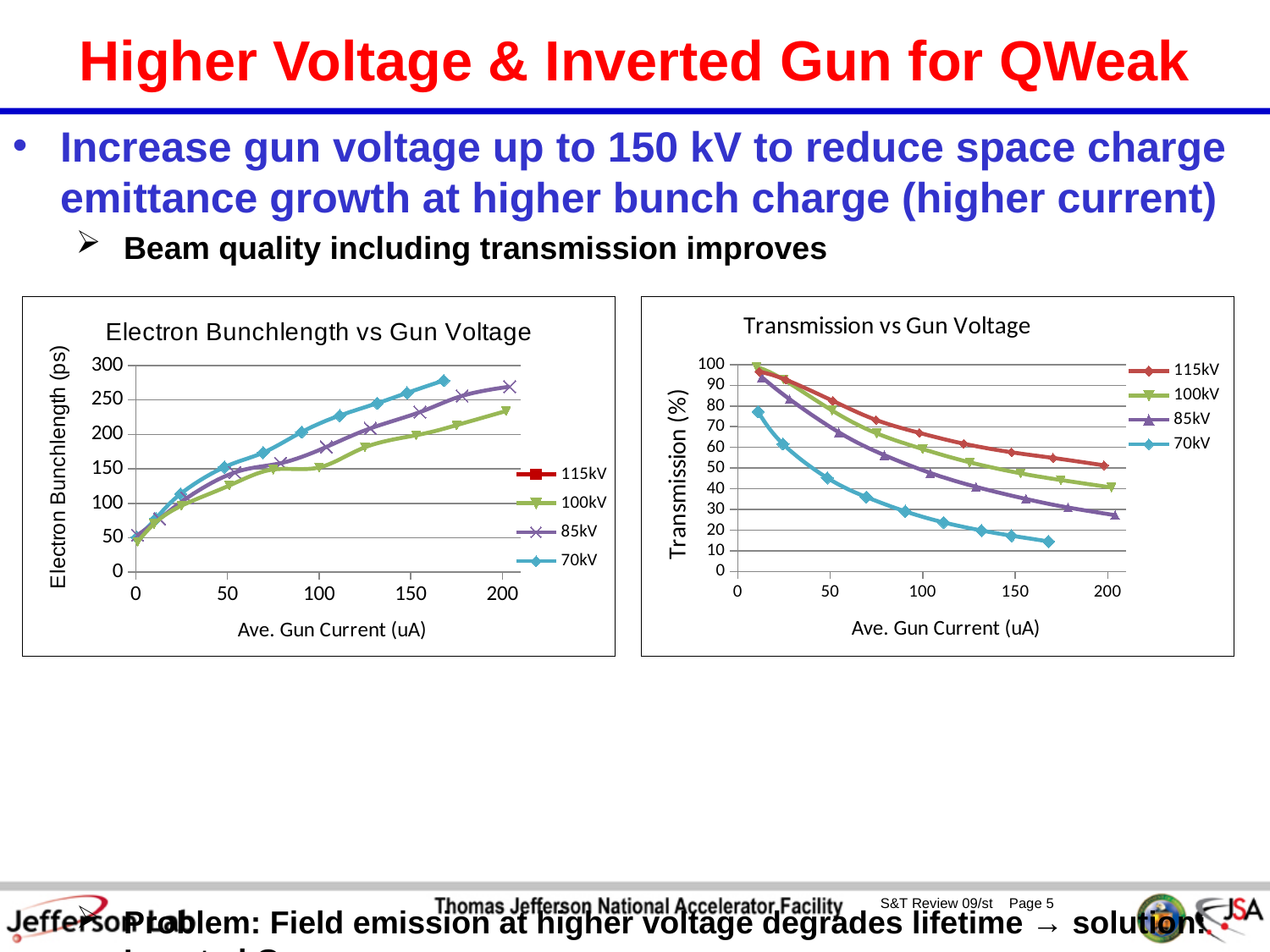
In the 'Electron Bunchlength vs Gun Voltage' chart, which series has the highest bunchlength at 150 uA? 70kV What type of chart is the 'Transmission vs Gun Voltage' chart? line chart In the 'Transmission vs Gun Voltage' chart, do the transmission values rise or fall as average gun current increases? fall How many series does the legend of the 'Electron Bunchlength vs Gun Voltage' chart list? 4 In the 'Transmission vs Gun Voltage' chart, is the 115kV transmission at 100 uA greater or less than 60? greater In the 'Electron Bunchlength vs Gun Voltage' chart, is the 70kV bunchlength at 100 uA greater or less than 200? greater How many series does the legend of the 'Transmission vs Gun Voltage' chart list? 4 In the 'Electron Bunchlength vs Gun Voltage' chart, do the bunchlength values rise or fall as average gun current increases? rise In the 'Transmission vs Gun Voltage' chart, which series has the highest transmission at 200 uA? 115kV What is the x-axis label of the 'Transmission vs Gun Voltage' chart? Ave. Gun Current (uA) In the 'Transmission vs Gun Voltage' chart, which series has the lowest transmission at 100 uA? 70kV